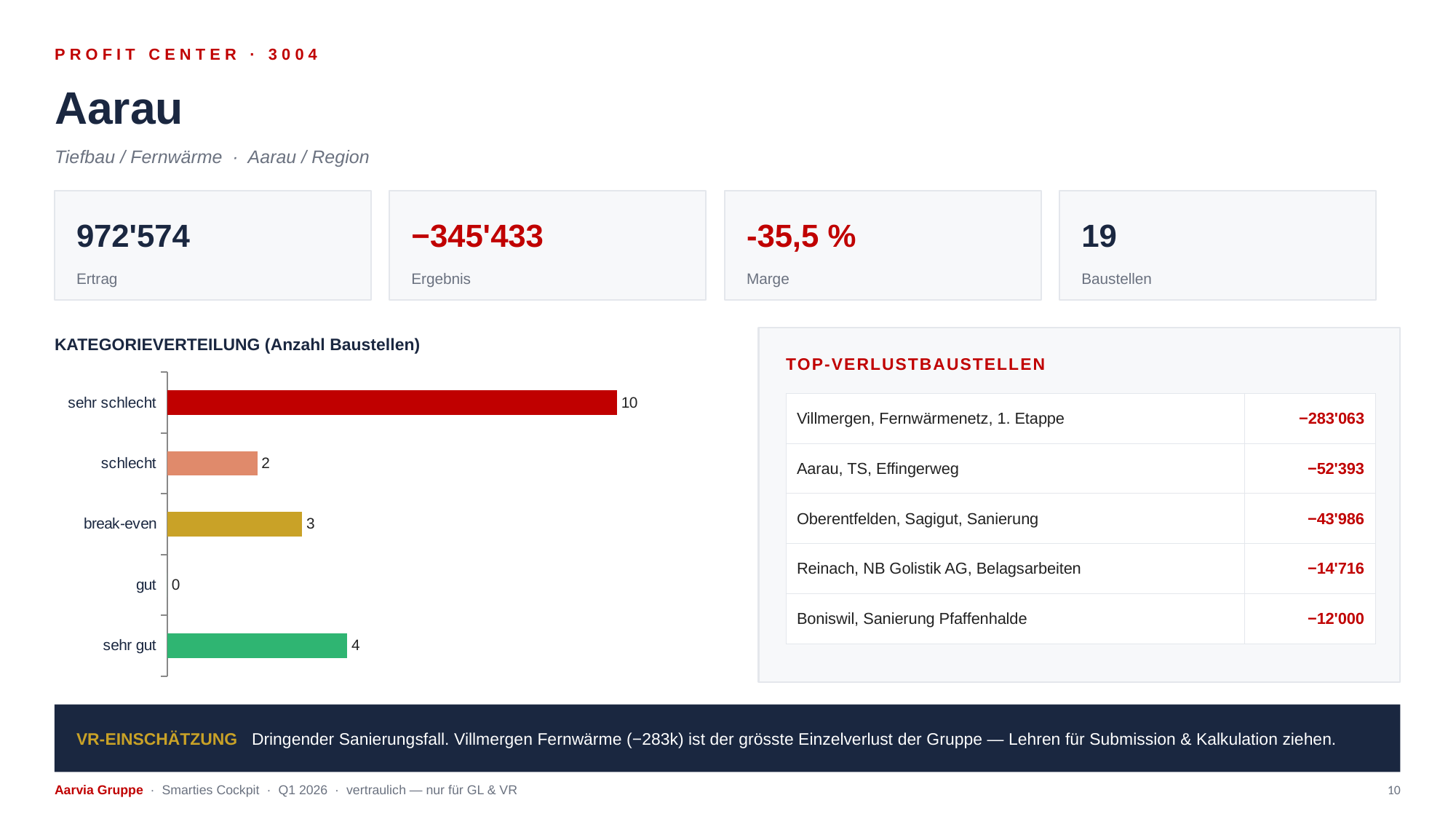
How many categories are shown in the Kategorieverteilung chart? 5 What is the full title of the bar chart on the slide? KATEGORIEVERTEILUNG (Anzahl Baustellen) What is the value for 'sehr schlecht' in the Kategorieverteilung chart? 10 What colour is the bar for 'sehr gut' in the Kategorieverteilung chart? green What is the value for 'sehr gut' in the Kategorieverteilung chart? 4 Which category has the lowest value in the Kategorieverteilung chart? gut What is the value for 'break-even' in the Kategorieverteilung chart? 3 What is the value for 'schlecht' in the Kategorieverteilung chart? 2 What is the difference between the values for 'sehr schlecht' and 'sehr gut' in the Kategorieverteilung chart? 6 In the Kategorieverteilung chart, which is larger: 'break-even' or 'schlecht'? break-even Which category has the highest value in the Kategorieverteilung chart? sehr schlecht What kind of chart is the Kategorieverteilung chart? bar chart